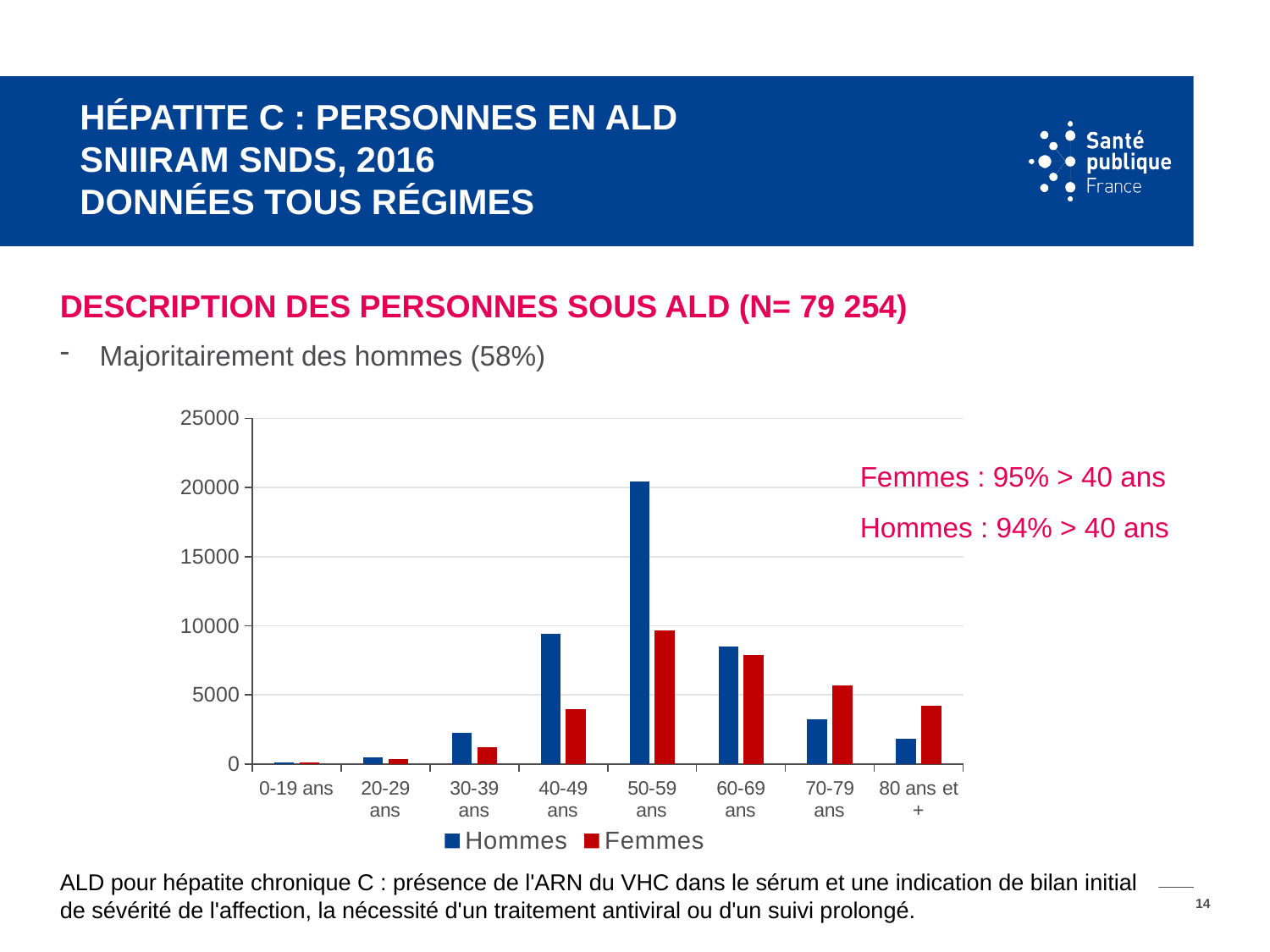
What kind of chart is shown on the slide? bar chart How many series does the chart legend list? 2 Is the value for Hommes in the 50-59 ans age group greater or less than 20000? greater Is the value for Femmes in the 70-79 ans age group greater or less than 5000? greater In the 40-49 ans age group, which series has the larger value, Hommes or Femmes? Hommes In the 70-79 ans age group, which series has the larger value, Hommes or Femmes? Femmes Which age group has the highest value for Hommes? 50-59 ans Which age group has the lowest value for Hommes? 0-19 ans Which colour represents the Femmes series in the chart? red Which age group has the highest value for Femmes? 50-59 ans How many age categories are shown on the x axis of the chart? 8 In the 80 ans et + age group, which series has the larger value, Hommes or Femmes? Femmes